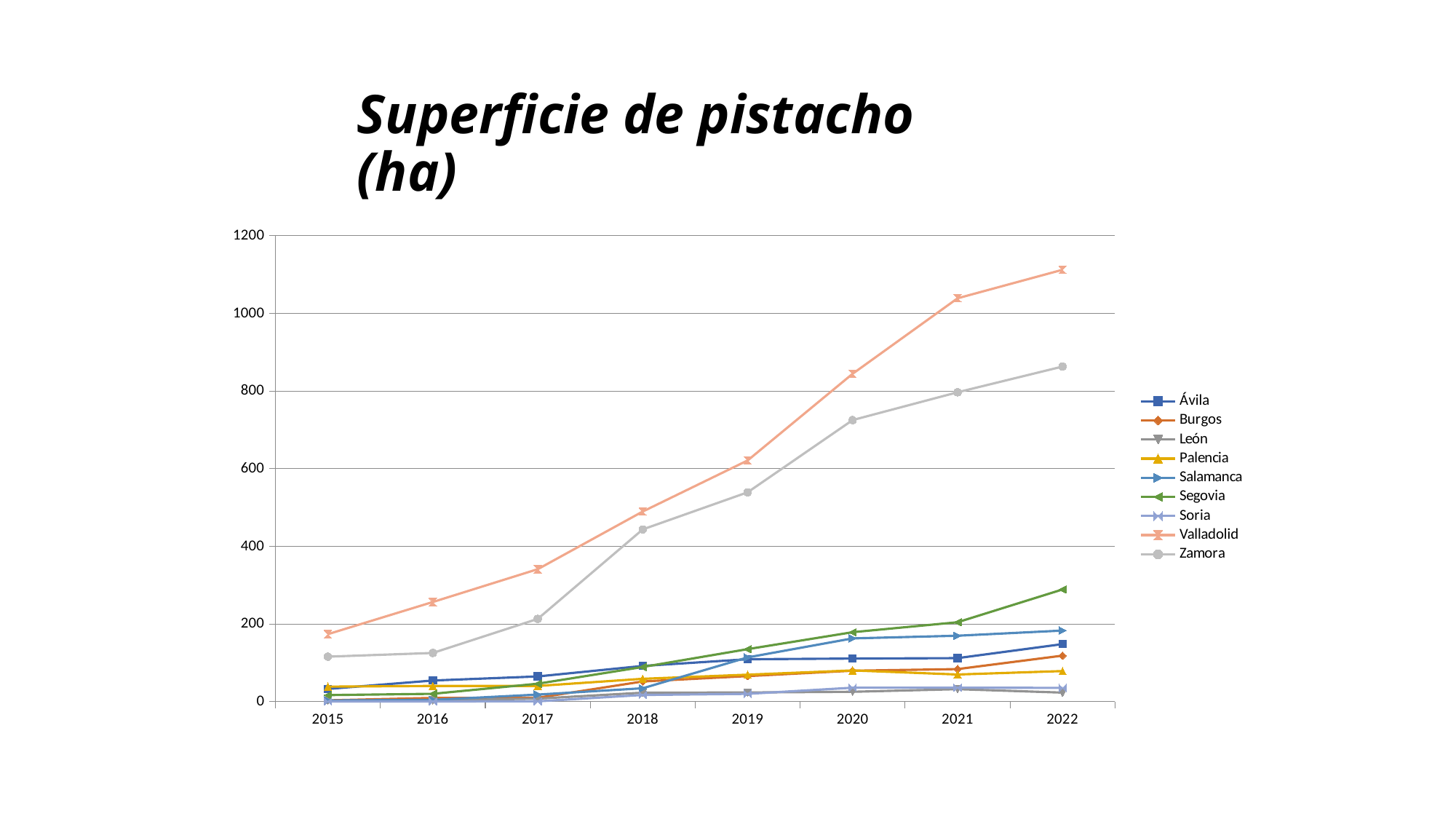
Is the value for Valladolid in 2022 greater or less than 1000? greater How many years are shown along the x axis? 8 How many series does the legend list? 9 Which is larger in 2022, Valladolid or Zamora? Valladolid Does the value for Valladolid rise or fall from 2015 to 2022? rise Is the value for Zamora in 2022 greater or less than 800? greater Which is larger in 2022, Segovia or Ávila? Segovia Which province has the highest value in 2022? Valladolid Is the value for Segovia in 2022 greater or less than 400? less What kind of chart is shown on the slide? line chart What is the title of the chart? Superficie de pistacho (ha)